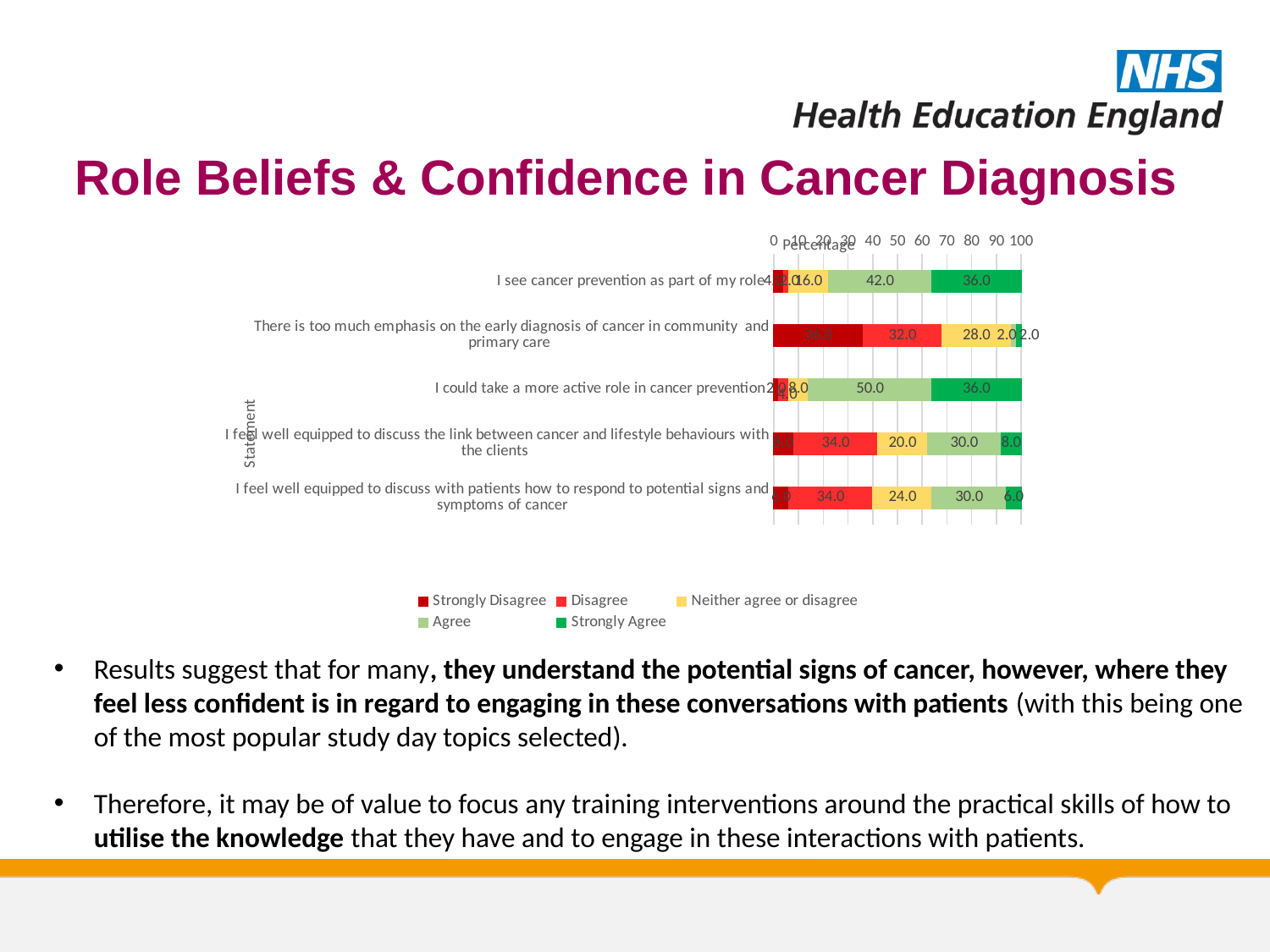
How many series does the legend list? 5 What is the Agree value for the statement 'I could take a more active role in cancer prevention'? 50.0 What is the Strongly Agree value for the statement 'I feel well equipped to discuss the link between cancer and lifestyle behaviours with the clients'? 8.0 What is the 'Neither agree or disagree' value for the statement 'I feel well equipped to discuss with patients how to respond to potential signs and symptoms of cancer'? 24.0 What is the Agree value for the statement 'I see cancer prevention as part of my role'? 42.0 How many statements are plotted on the chart? 5 Which statement has the highest Agree value? I could take a more active role in cancer prevention What is the difference between the Agree values for 'I could take a more active role in cancer prevention' and 'I see cancer prevention as part of my role'? 8.0 What kind of chart is shown on the slide? bar chart What is the Disagree value for the statement 'There is too much emphasis on the early diagnosis of cancer in community and primary care'? 32.0 What is the title of the horizontal axis? Percentage Which has the larger Agree value: 'I see cancer prevention as part of my role' or 'I feel well equipped to discuss the link between cancer and lifestyle behaviours with the clients'? I see cancer prevention as part of my role